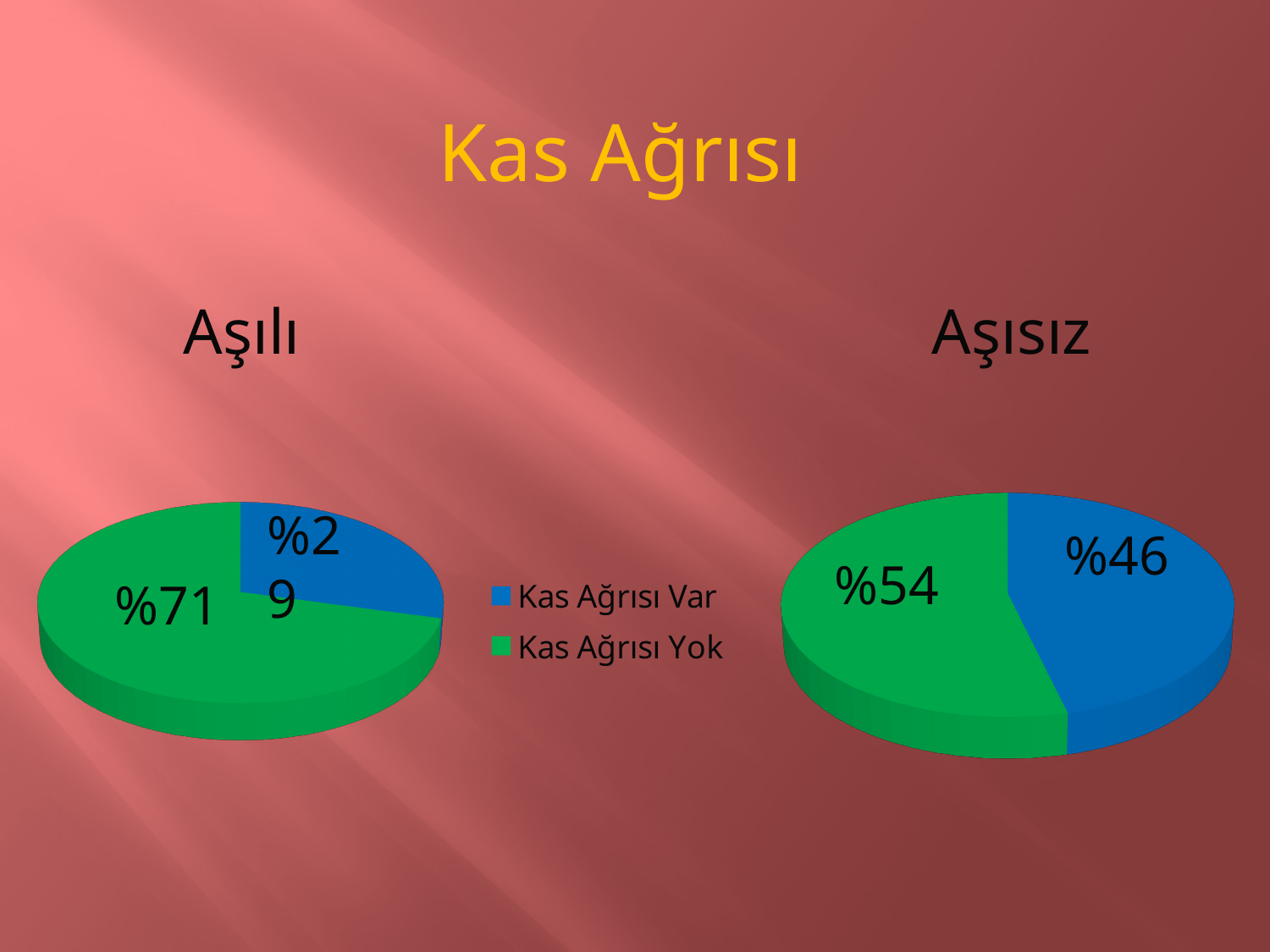
In the Aşısız pie chart, what share is labelled for Kas Ağrısı Var? %46 In the Aşısız pie chart, what share is labelled for Kas Ağrısı Yok? %54 In the Aşısız pie chart, what is the difference between the Kas Ağrısı Yok and Kas Ağrısı Var shares? 8 percentage points In the Aşılı pie chart, what share is labelled for Kas Ağrısı Yok? %71 Which colour represents Kas Ağrısı Yok in the legend? Green In the Aşılı pie chart, which slice is the largest? Kas Ağrısı Yok How many slices does the Aşısız pie chart have? 2 In the Aşılı pie chart, what is the difference between the Kas Ağrısı Yok and Kas Ağrısı Var shares? 42 percentage points In the Aşısız pie chart, which slice is the smallest? Kas Ağrısı Var What type of chart is used on this slide? Pie chart In the Aşılı pie chart, what share is labelled for Kas Ağrısı Var? %29 Is the Kas Ağrısı Var share larger in the Aşılı pie chart or in the Aşısız pie chart? Aşısız